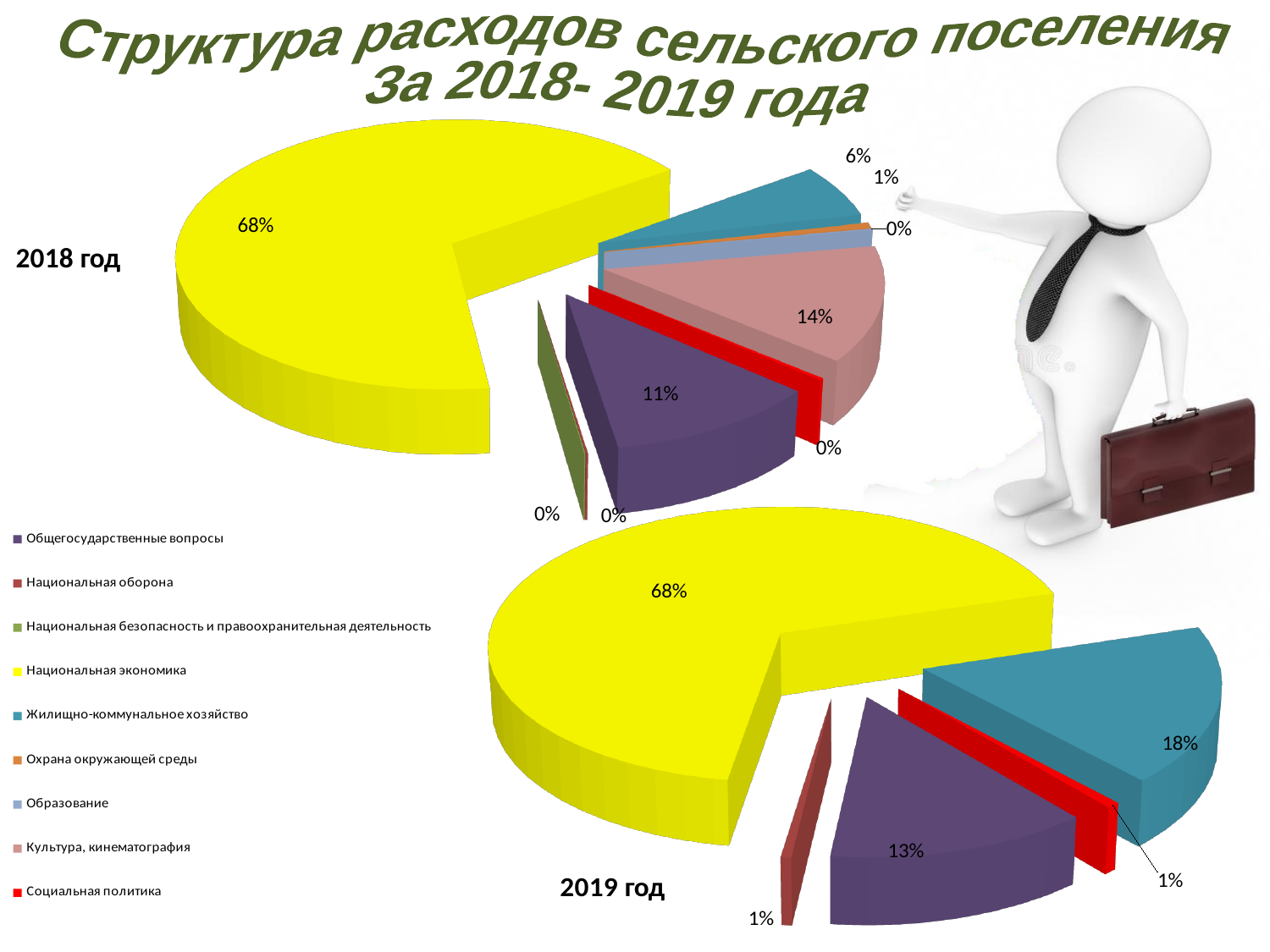
In the 2019 год pie chart, what share is shown for Общегосударственные вопросы (purple slice)? 13% In the 2019 год pie chart, what share is shown for Жилищно-коммунальное хозяйство (teal slice)? 18% In the 2018 год pie chart, which category has the largest share? Национальная экономика In the 2018 год pie chart, what share is shown for Национальная экономика (yellow slice)? 68% How many categories does the legend list? 9 What colour represents Национальная экономика in the legend? Yellow In the 2018 год pie chart, what share is shown for Общегосударственные вопросы (purple slice)? 11% Which is larger in the 2018 год pie chart: the share for Культура, кинематография or the share for Общегосударственные вопросы? Культура, кинематография In the 2019 год pie chart, which category has the largest share? Национальная экономика What is the difference between the Жилищно-коммунальное хозяйство share in 2019 год (18%) and in 2018 год (6%)? 12 percentage points What type of chart is used to show the 2018 год and 2019 год expenditure structure? Pie chart In the 2018 год pie chart, what share is shown for Культура, кинематография (pink slice)? 14%